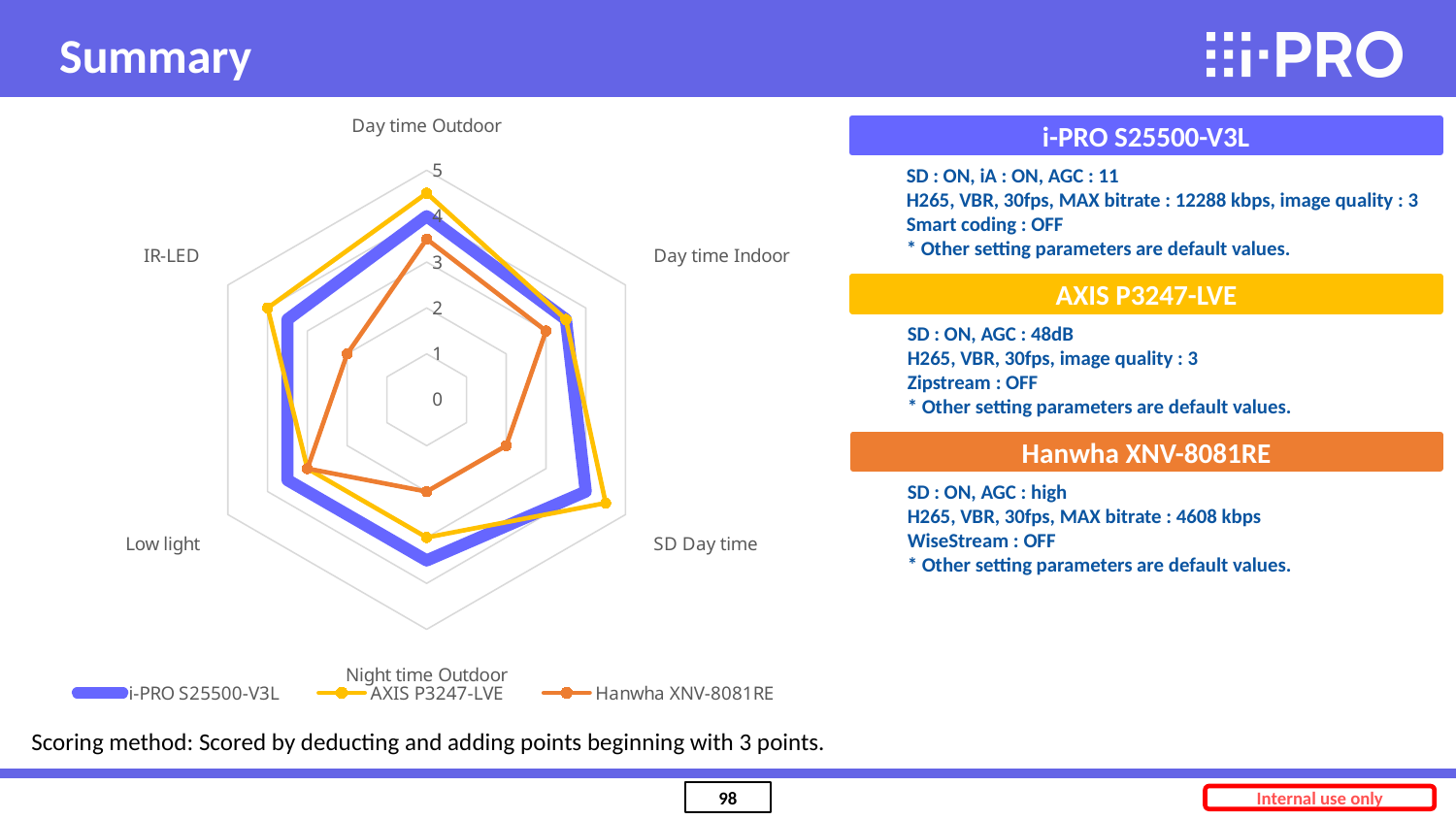
Is the value for i-PRO S25500-V3L on Day time Indoor greater or less than 3? greater How many categories (axes) does the radar chart have? 6 Is the value for Hanwha XNV-8081RE on SD Day time greater or less than 3? less On SD Day time, which is larger: the value for AXIS P3247-LVE or the value for Hanwha XNV-8081RE? AXIS P3247-LVE Which series is drawn in yellow on the radar chart? AXIS P3247-LVE Is the value for AXIS P3247-LVE on SD Day time greater or less than 4? greater Which series is drawn in blue on the radar chart? i-PRO S25500-V3L Which series has the lowest value on Night time Outdoor? Hanwha XNV-8081RE What is the maximum value shown on the radar chart's scale? 5 What kind of chart is shown on the slide? Radar chart How many series does the legend of the radar chart list? 3